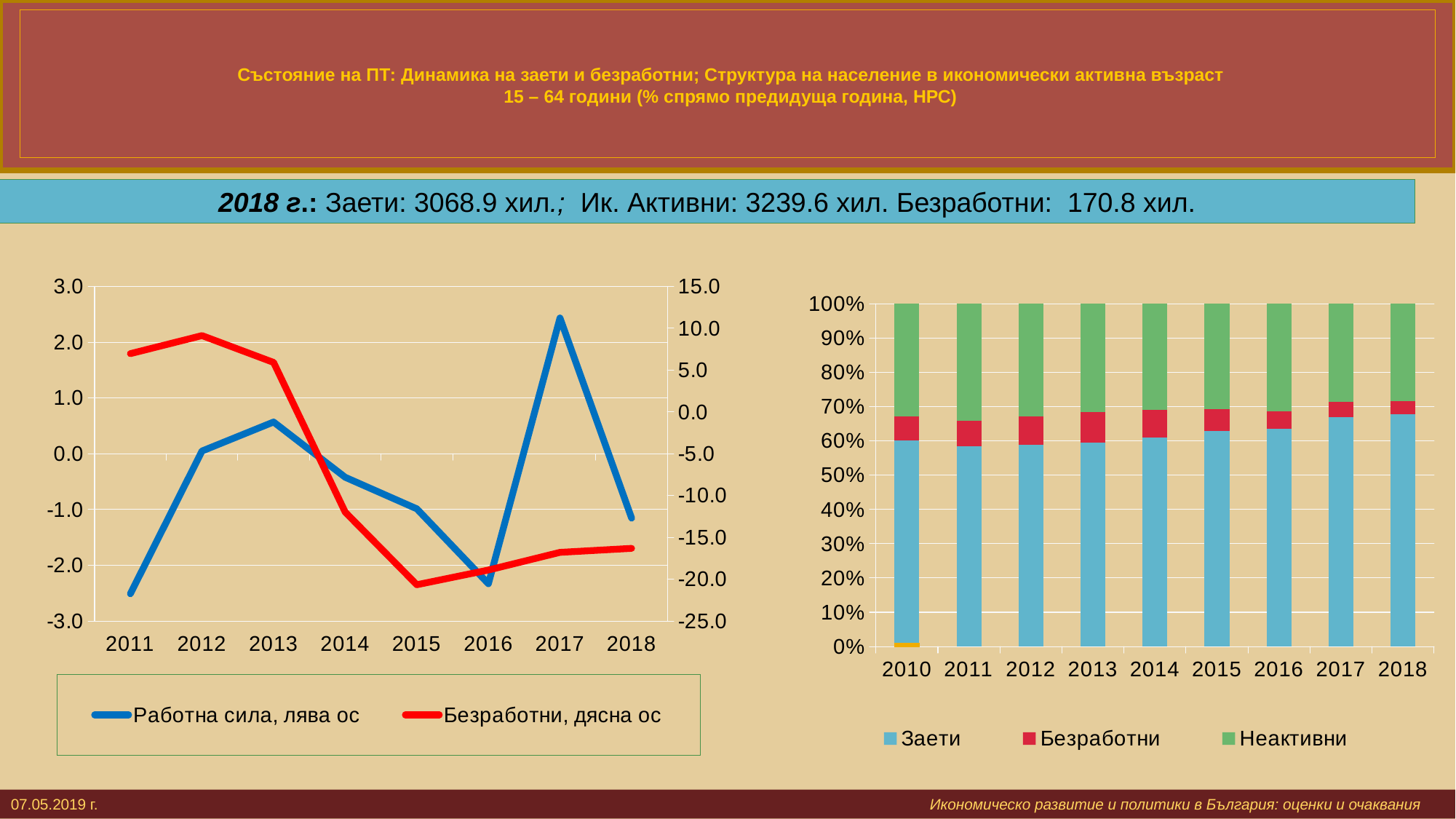
In the left chart, in which year does the series 'Работна сила, лява ос' reach its highest value? 2017 How many bars are there in the right chart? 9 In the left chart, in which year does the series 'Безработни, дясна ос' reach its lowest value? 2015 How many series does the legend of the right chart list? 3 In the left chart, does the series 'Безработни, дясна ос' rise or fall from 2012 to 2015? fall In the left chart, is the value of 'Безработни, дясна ос' for 2015 greater or less than -15.0 on the right axis? less What kind of chart is the chart on the left side of the slide? line chart In the right chart, is the share of 'Неактивни' in 2018 greater or less than 40%? less How many series does the legend of the left chart list? 2 What kind of chart is the chart on the right side of the slide? bar chart In the left chart, is the value of 'Работна сила, лява ос' for 2017 greater or less than 2.0? greater How many years are shown on the x axis of the left chart? 8